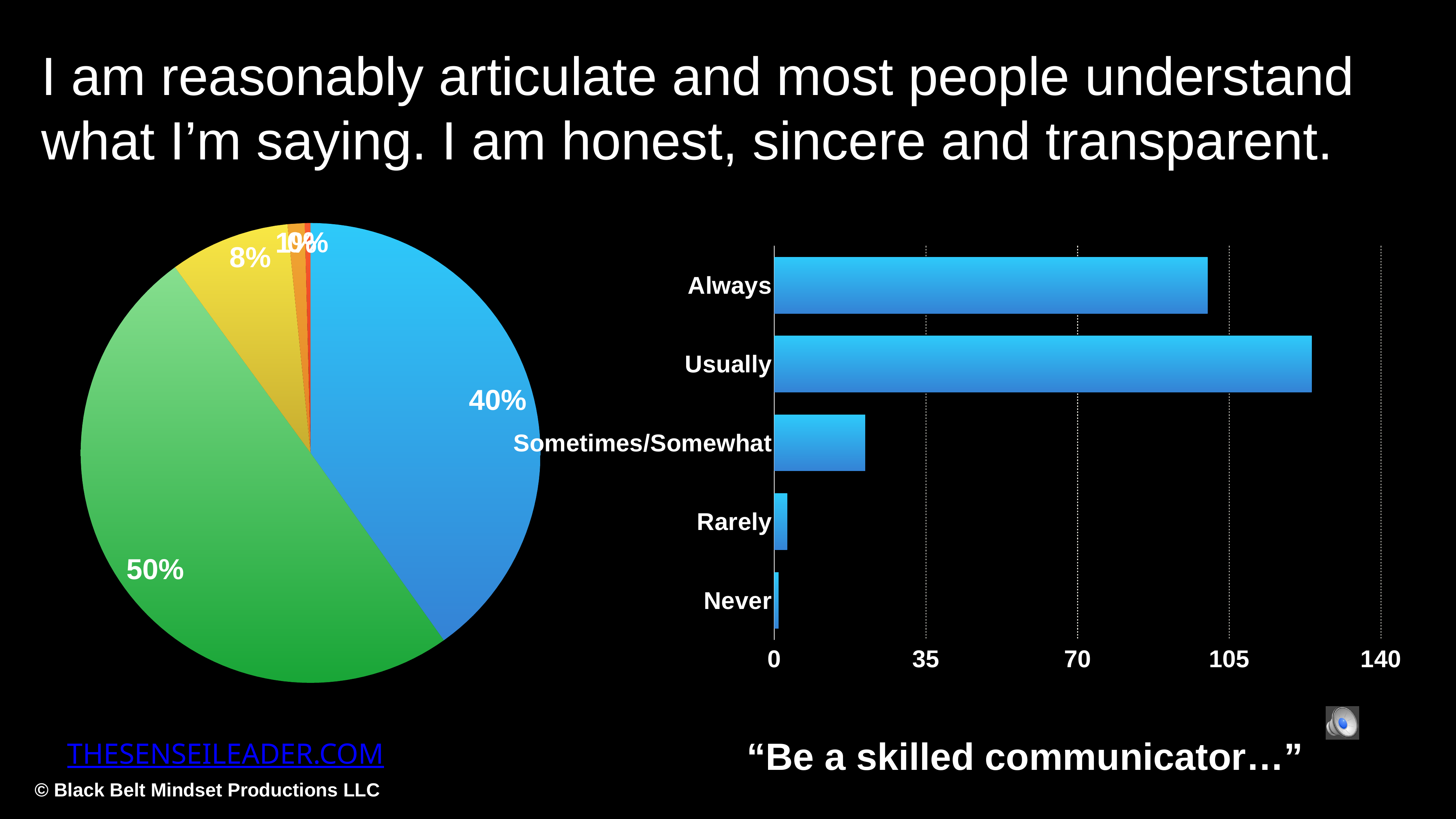
In the pie chart on the left, what share does the green slice have? 50% In the bar chart on the right, is the value for Usually greater or less than 105? greater In the bar chart on the right, which category has the highest value? Usually In the bar chart on the right, how many categories are shown? 5 In the bar chart on the right, is the value for Always greater or less than 105? less In the bar chart on the right, which category has the lowest value? Never In the pie chart on the left, which colour slice is the largest? green In the pie chart on the left, what share does the blue slice have? 40% What kind of chart is the chart on the right of the slide? bar chart In the bar chart on the right, is the value for Sometimes/Somewhat greater or less than 35? less What kind of chart is the chart on the left of the slide? pie chart In the pie chart on the left, what share does the yellow slice have? 8%